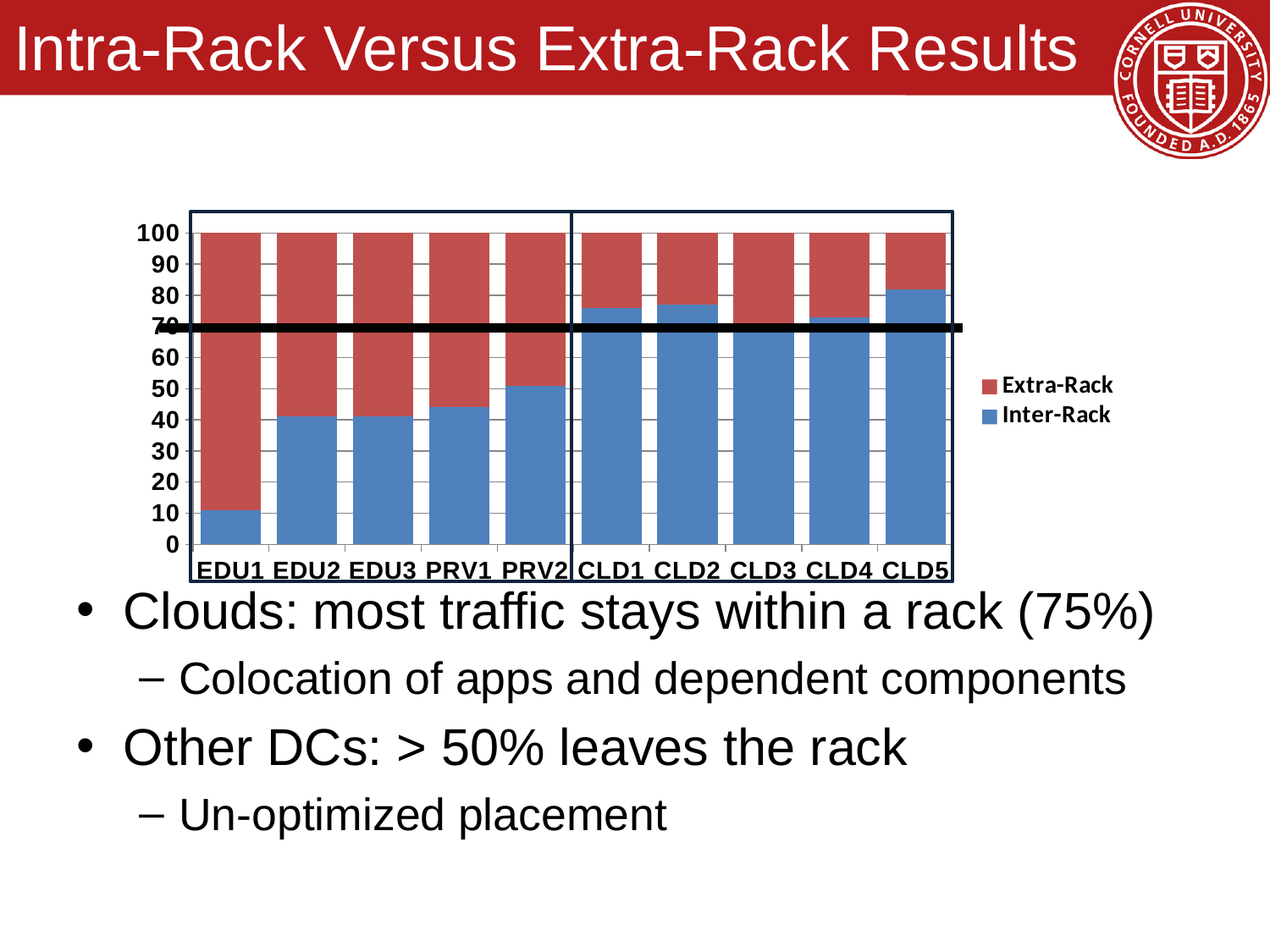
How many categories are shown along the x axis of the chart? 10 What kind of chart is shown on the slide? stacked bar chart Which category has the lowest Inter-Rack value? EDU1 Which has the larger Extra-Rack portion, EDU1 or CLD5? EDU1 Is the Inter-Rack value for CLD5 greater or less than 80? greater Is the Inter-Rack value for PRV1 greater or less than 50? less Which colour represents the Extra-Rack series in the chart? red Is the Inter-Rack value for EDU1 greater or less than 20? less Which category has the highest Inter-Rack value? CLD5 Which has the larger Inter-Rack value, PRV2 or CLD1? CLD1 How many series does the chart's legend list? 2